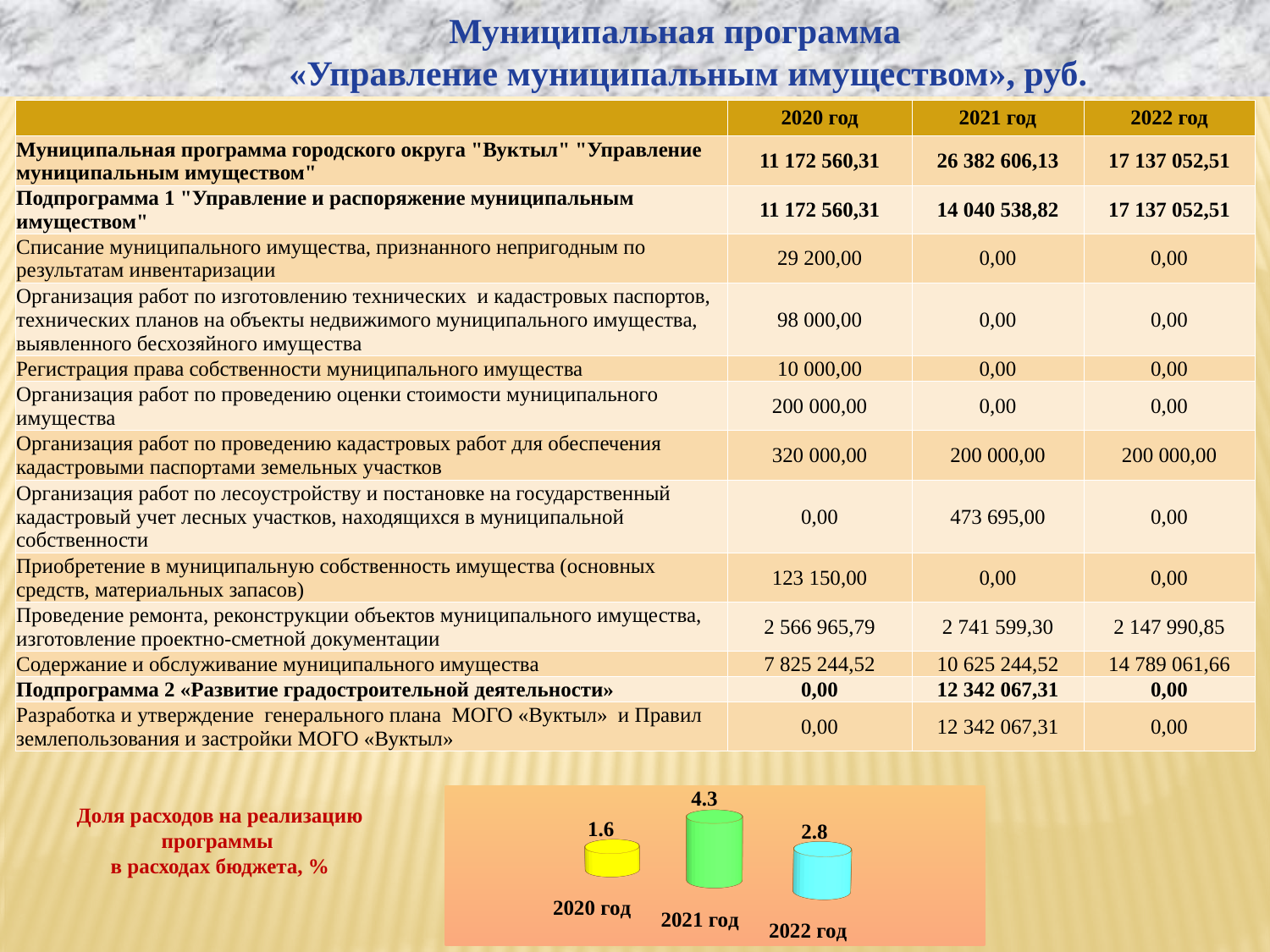
In the chart at the bottom of the slide, what is the difference between the values for 2021 год and 2022 год? 1.5 What kind of chart is shown at the bottom of the slide? Bar chart In the chart at the bottom of the slide, do the values rise or fall from 2021 год to 2022 год? Fall What colour is the bar for 2021 год in the chart at the bottom of the slide? Green In the chart at the bottom of the slide, what is the difference between the values for 2021 год and 2020 год? 2.7 How many categories (years) are shown in the chart at the bottom of the slide? 3 In the chart at the bottom of the slide, what is the value for 2021 год? 4.3 In the chart at the bottom of the slide, what is the value for 2022 год? 2.8 In the chart at the bottom of the slide, which year has the lowest value? 2020 год In the chart at the bottom of the slide, which is larger: the value for 2022 год or the value for 2020 год? 2022 год In the chart at the bottom of the slide, what is the value for 2020 год? 1.6 In the chart at the bottom of the slide, which year has the highest value? 2021 год